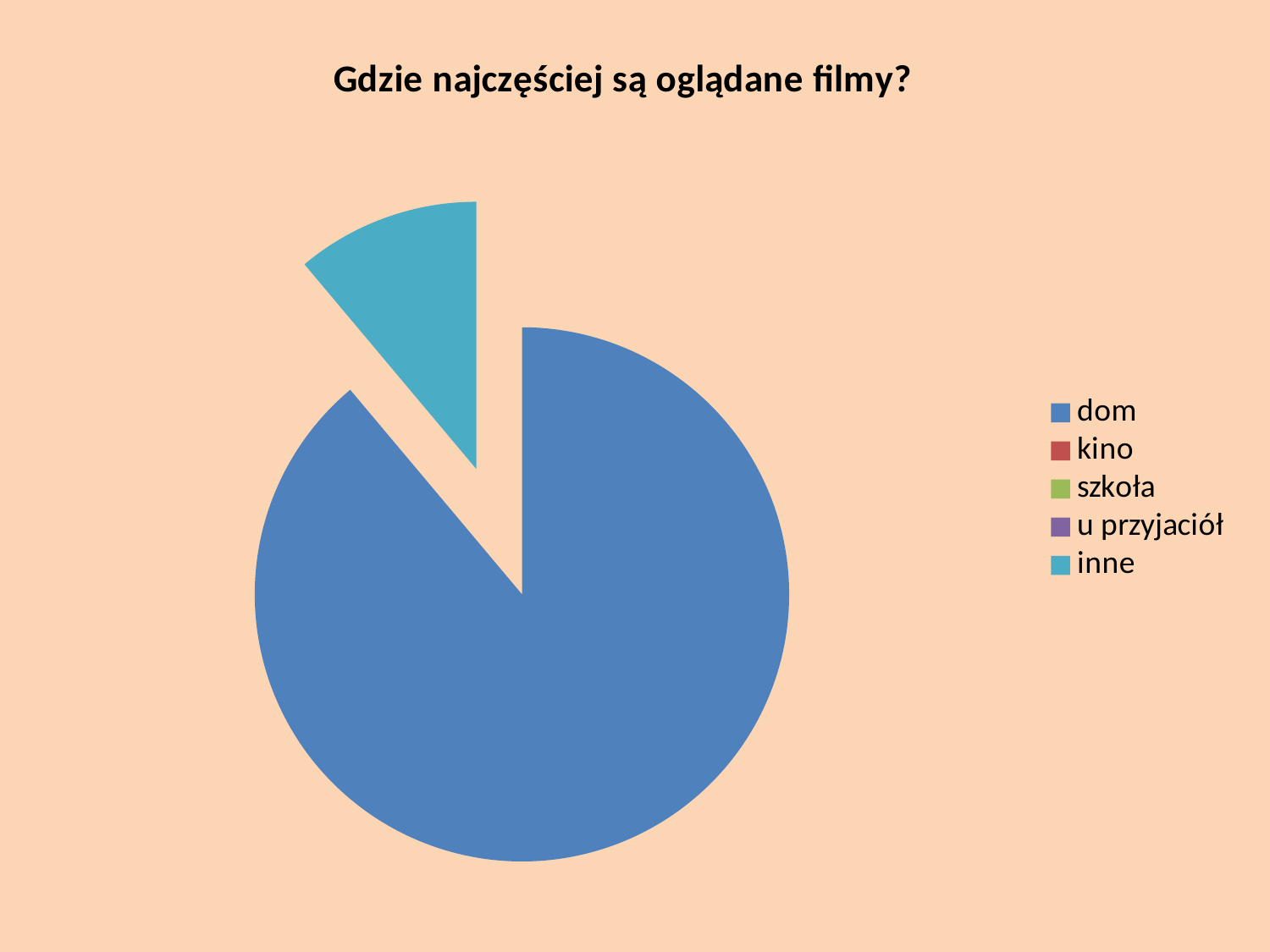
How many slices are visibly drawn in the pie? 2 Does the inne slice take up more or less than a quarter of the pie? less Which slice is smaller, inne or dom? inne Which category has the largest slice of the pie? dom How many entries does the chart's legend list? 5 What kind of chart is shown on the slide? pie chart Which slice is larger, dom or inne? dom Does the dom slice take up more or less than half of the pie? more Which slice is pulled out (exploded) from the rest of the pie? inne What is the title of the chart? Gdzie najczęściej są oglądane filmy?